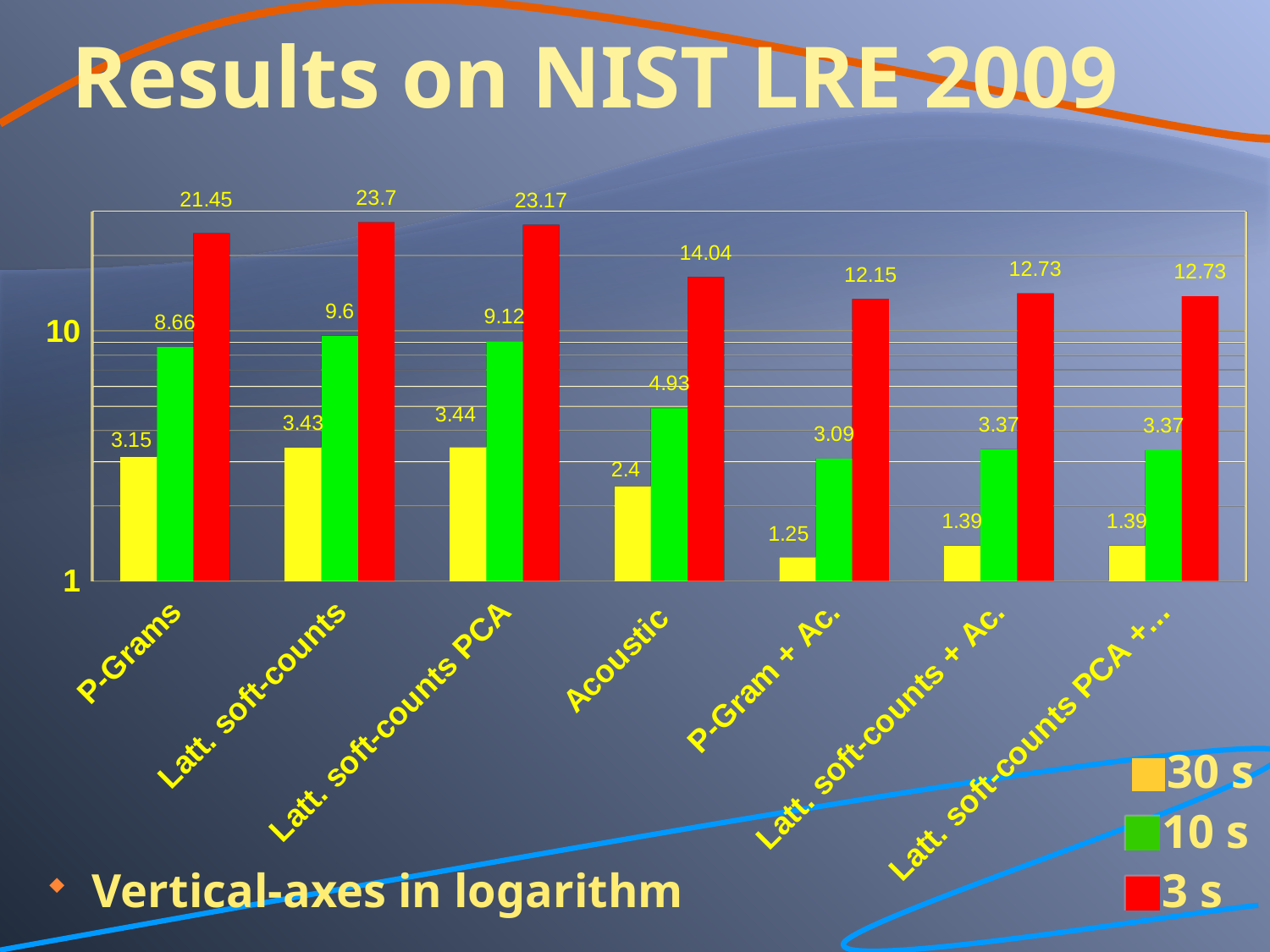
Which category has the highest 3 s value? Latt. soft-counts How many series does the legend list? 3 What is the difference between the 3 s and 30 s values for Acoustic? 11.64 Is the 3 s value for Acoustic greater or less than 10? greater Which category has the lowest 30 s value? P-Gram + Ac. What is the 30 s value for P-Gram + Ac.? 1.25 How many categories are shown on the x axis? 7 What is the 10 s value for Acoustic? 4.93 Which has the larger 10 s value, Latt. soft-counts or Latt. soft-counts PCA? Latt. soft-counts Which series is shown in red in the legend? 3 s What is the 3 s value for P-Grams? 21.45 What kind of chart is shown on the slide? bar chart